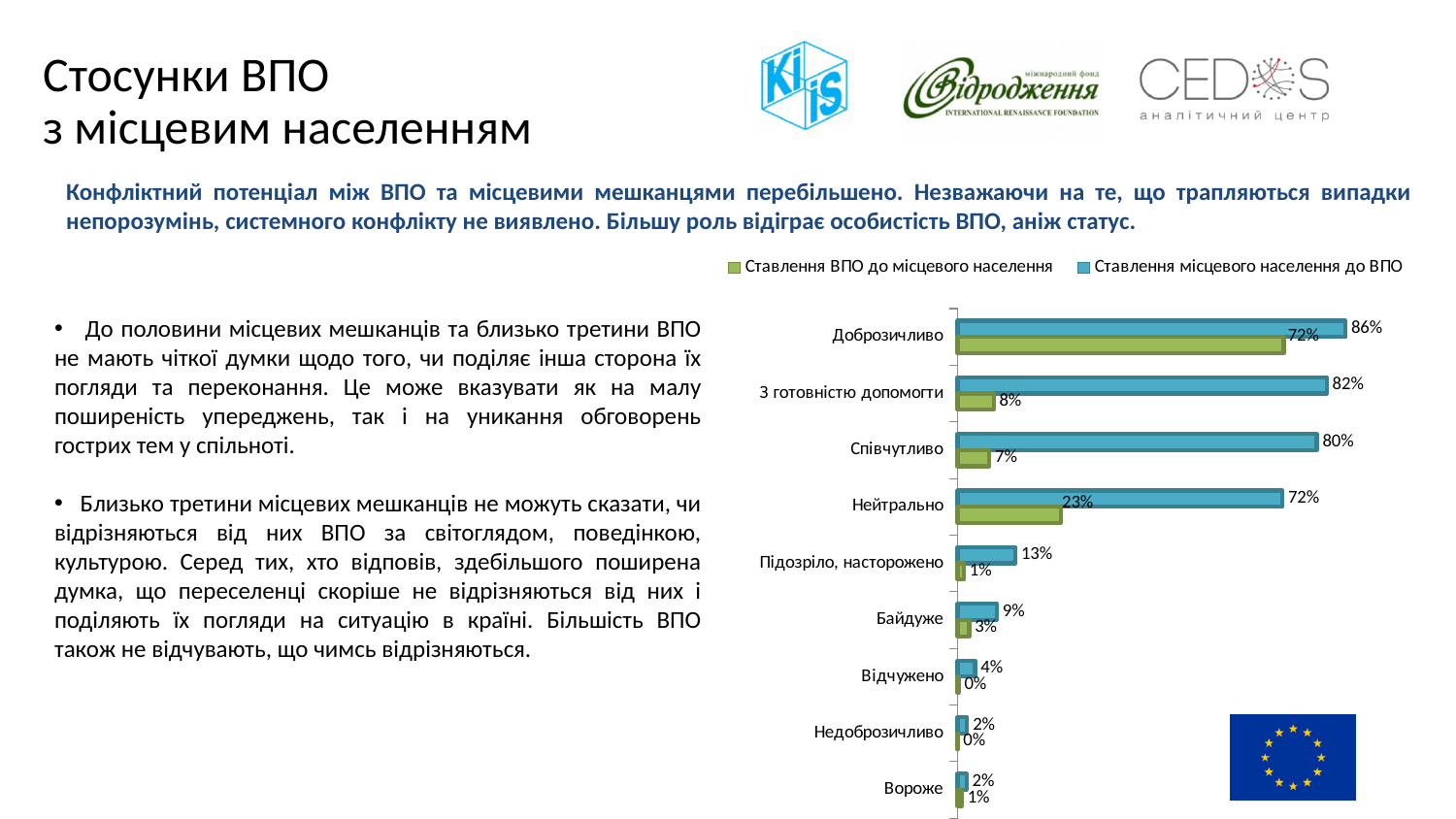
How many categories are shown on the chart? 9 Which colour represents the series "Ставлення ВПО до місцевого населення"? green How many series does the chart legend list? 2 What is the difference between the two series for "Доброзичливо"? 14% What is the value for "З готовністю допомогти" in the series "Ставлення ВПО до місцевого населення"? 8% Which category has the lowest value in the series "Ставлення місцевого населення до ВПО"? Недоброзичливо and Вороже (2%) What is the difference between the two series for "Співчутливо"? 73% For "Підозріло, насторожено", which series has the larger value? Ставлення місцевого населення до ВПО Which category has the highest value in the series "Ставлення місцевого населення до ВПО"? Доброзичливо What is the value for "Нейтрально" in the series "Ставлення ВПО до місцевого населення"? 23% What is the value for "Доброзичливо" in the series "Ставлення місцевого населення до ВПО"? 86% What type of chart is shown on the slide? bar chart